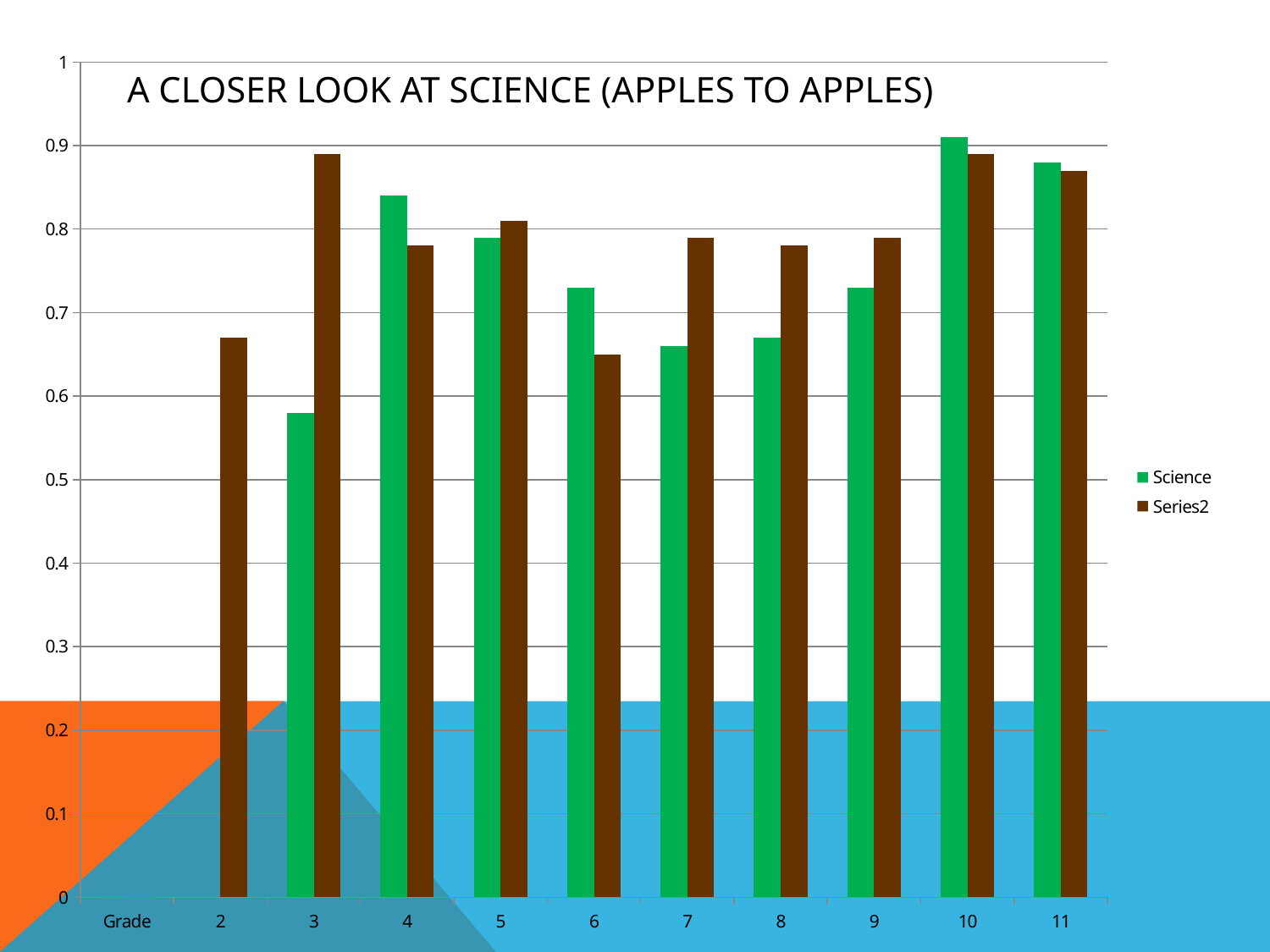
Is the Series2 value for category 3 greater or less than 0.8? greater Is the Science value for category 10 greater or less than 0.9? greater Is the Series2 value for category 6 greater or less than 0.7? less How many series does the legend list? 2 For category 4, which series has the larger value, Science or Series2? Science Which category has the lowest Science value? 3 What is the title of the chart? A CLOSER LOOK AT SCIENCE (APPLES TO APPLES) For category 7, which series has the larger value, Science or Series2? Series2 What kind of chart is shown on the slide? bar chart How many categories are shown along the x axis? 11 Which category has the highest Science value? 10